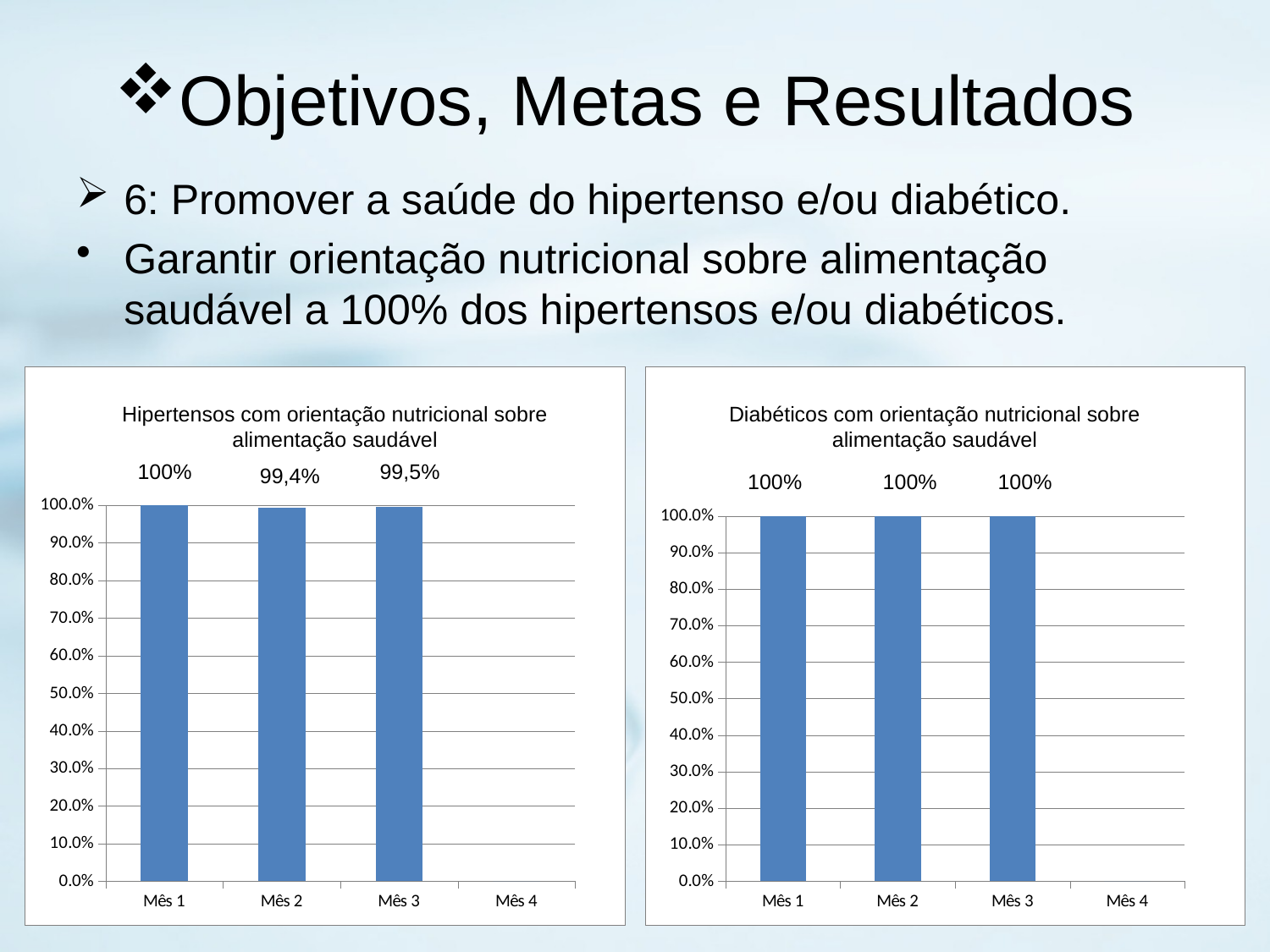
In the chart titled 'Hipertensos com orientação nutricional sobre alimentação saudável', what is the difference between the values for Mês 1 and Mês 2? 0,6% In the chart titled 'Hipertensos com orientação nutricional sobre alimentação saudável', what is the value for Mês 2? 99,4% In the chart titled 'Diabéticos com orientação nutricional sobre alimentação saudável', what is the value for Mês 1? 100% In the chart titled 'Diabéticos com orientação nutricional sobre alimentação saudável', do the values change from Mês 1 to Mês 3? No, they stay at 100% In the chart titled 'Diabéticos com orientação nutricional sobre alimentação saudável', how many bars are plotted? 3 In the chart titled 'Diabéticos com orientação nutricional sobre alimentação saudável', what is the value for Mês 3? 100% In the chart titled 'Hipertensos com orientação nutricional sobre alimentação saudável', which month has the highest value? Mês 1 What type of chart is the chart on the right of the slide? Bar chart In the chart titled 'Hipertensos com orientação nutricional sobre alimentação saudável', which is larger, the value for Mês 2 or Mês 3? Mês 3 In the chart titled 'Hipertensos com orientação nutricional sobre alimentação saudável', how many categories are shown on the x axis? 4 In the chart titled 'Hipertensos com orientação nutricional sobre alimentação saudável', what is the value for Mês 3? 99,5%